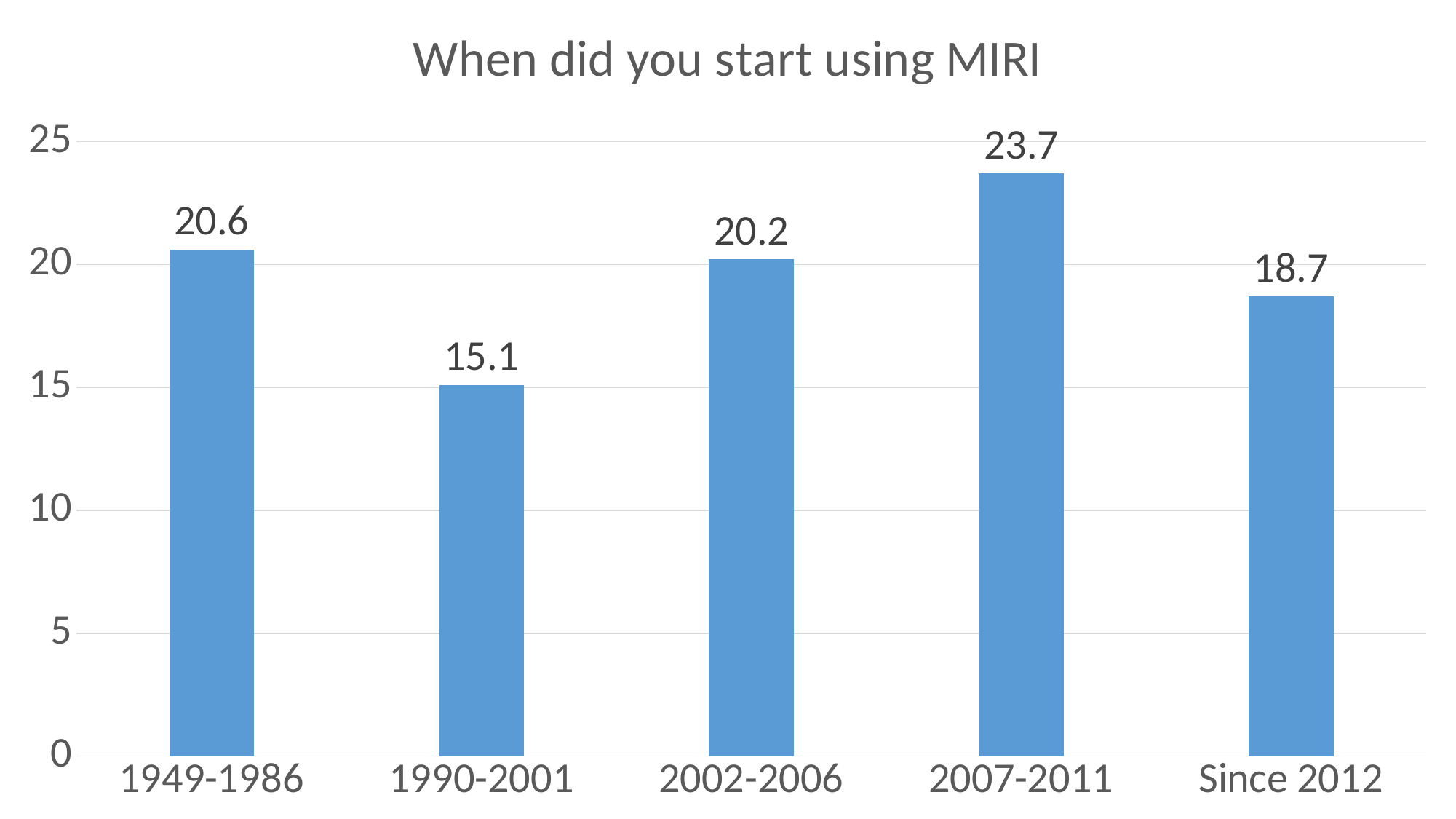
What is the difference between the values for 1949-1986 and 2002-2006? 0.4 What is the difference between the values for 2007-2011 and 1990-2001? 8.6 What is the title of the chart? When did you start using MIRI How many categories are shown on the x axis? 5 What is the value for 1949-1986? 20.6 What is the value for 1990-2001? 15.1 Which category has the lowest value? 1990-2001 Is the value for 1990-2001 greater or less than 20? less Which is larger, the value for 2002-2006 or the value for Since 2012? 2002-2006 What is the value for Since 2012? 18.7 Which category has the highest value? 2007-2011 What kind of chart is this? bar chart